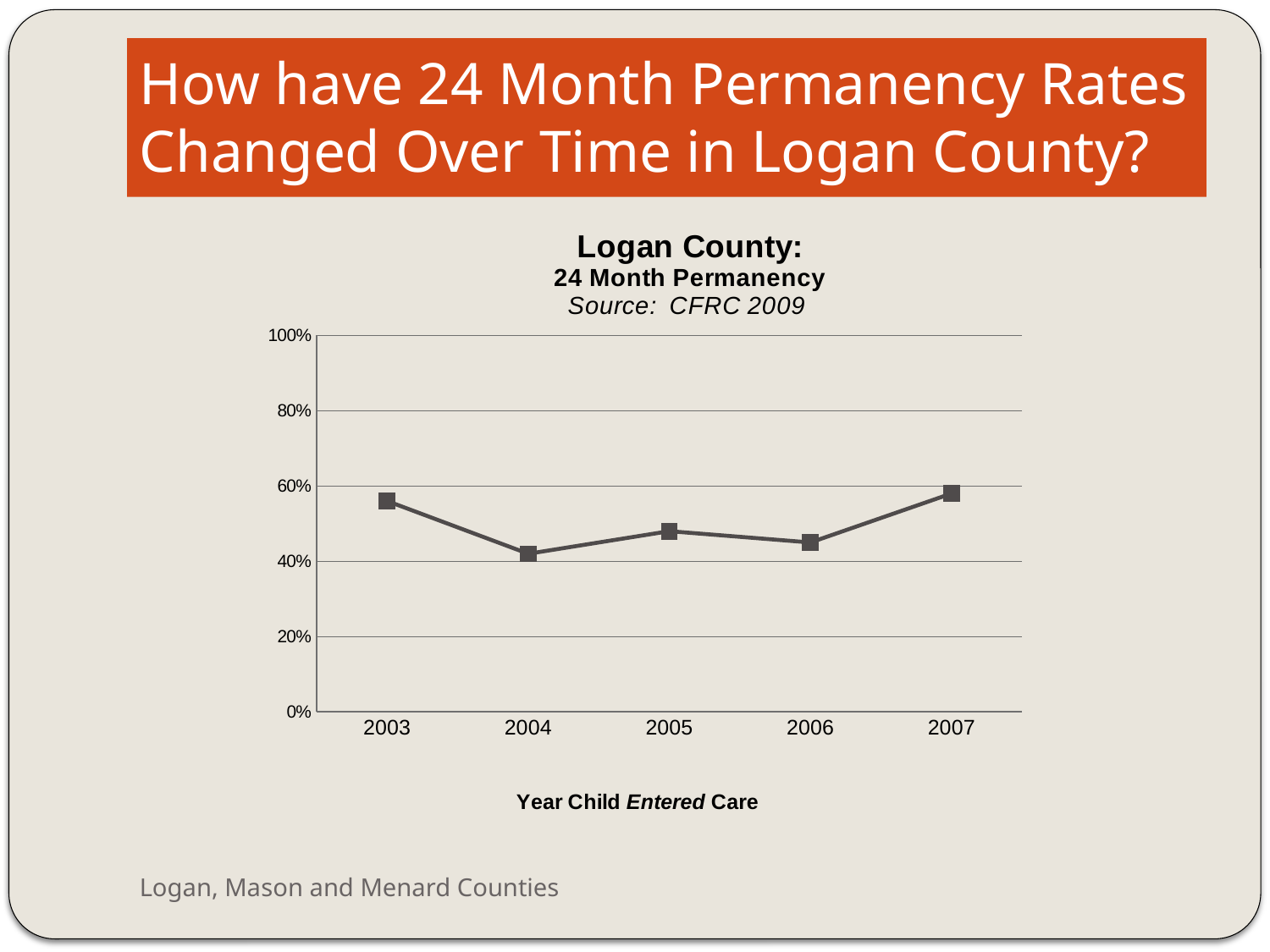
Does the 24 month permanency rate rise or fall from 2003 to 2004? fall What kind of chart is shown on the slide? line chart Does the 24 month permanency rate rise or fall from 2006 to 2007? rise How many years are plotted on the x axis of the chart? 5 What is the label of the x axis of the chart? Year Child Entered Care Is the 24 month permanency value for 2007 greater or less than 80%? less Is the 24 month permanency value for 2003 greater or less than 40%? greater Is the 24 month permanency value for 2004 greater or less than 60%? less Which year has the higher 24 month permanency rate, 2007 or 2006? 2007 Which year has the higher 24 month permanency rate, 2003 or 2004? 2003